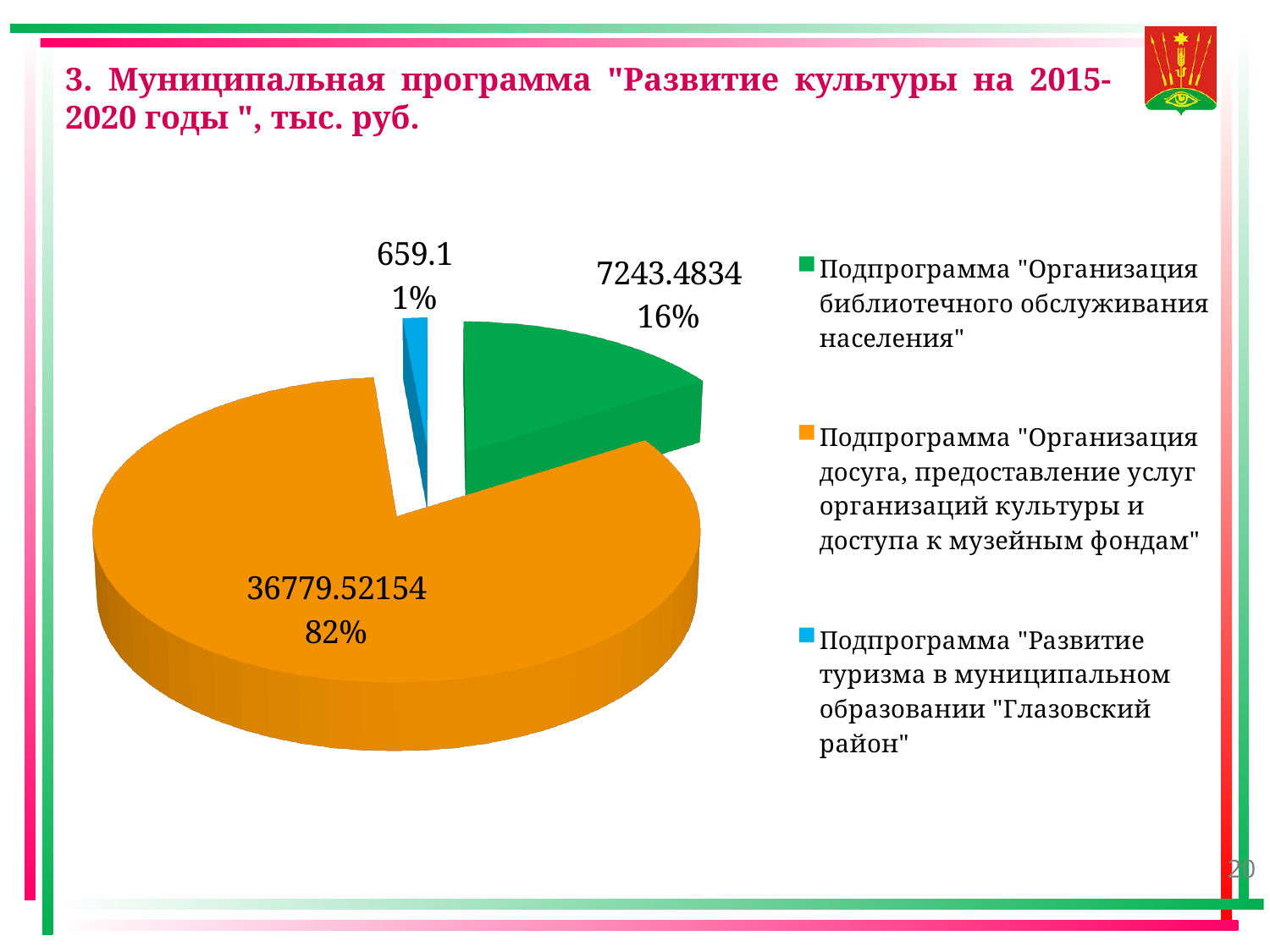
What is the difference between the value for the leisure/culture subprogram (36779.52154) and the library services subprogram (7243.4834)? 29536.03814 What is the value for the subprogram "Организация досуга, предоставление услуг организаций культуры и доступа к музейным фондам"? 36779.52154 How many entries does the legend list? 3 What share of the pie does the subprogram "Организация досуга, предоставление услуг организаций культуры и доступа к музейным фондам" represent? 82% What share of the pie does the subprogram "Организация библиотечного обслуживания населения" represent? 16% Which subprogram has the largest slice of the pie? Подпрограмма "Организация досуга, предоставление услуг организаций культуры и доступа к музейным фондам" What type of chart is shown on the slide? Pie chart Which subprogram has the smallest slice of the pie? Подпрограмма "Развитие туризма в муниципальном образовании "Глазовский район"" What is the value for the subprogram "Развитие туризма в муниципальном образовании "Глазовский район""? 659.1 How many slices does the pie chart have? 3 What is the value for the subprogram "Организация библиотечного обслуживания населения"? 7243.4834 Which colour represents the subprogram "Организация библиотечного обслуживания населения" in the pie chart? Green